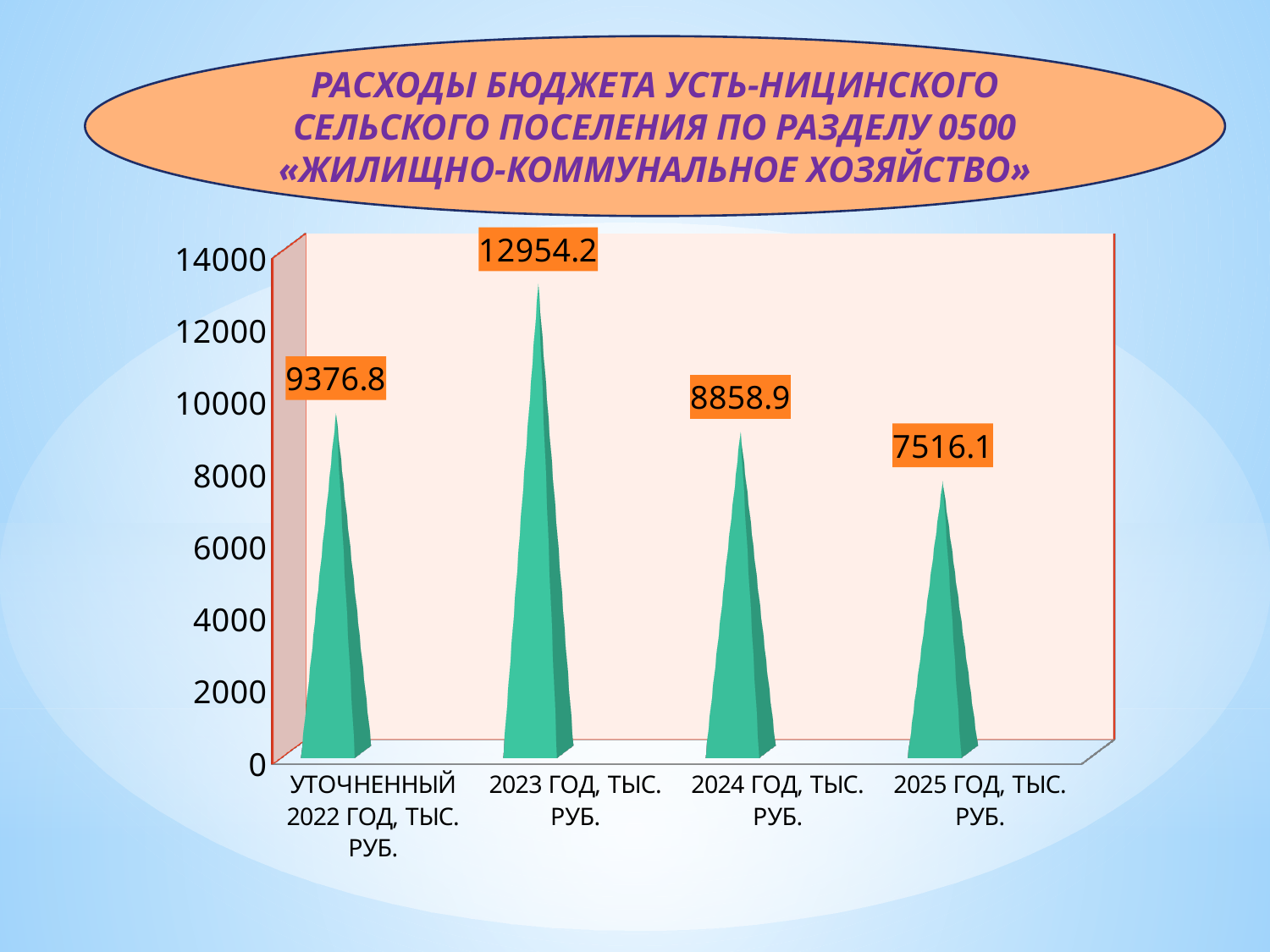
What is the difference between the values for 2024 год and 2025 год? 1342.8 How many categories are shown on the x axis? 4 From 2023 год to 2025 год, do the values rise or fall? fall What is the value for 2023 год, тыс. руб.? 12954.2 What is the difference between the values for 2023 год and Уточненный 2022 год? 3577.4 What is the value for 2025 год, тыс. руб.? 7516.1 What is the value for Уточненный 2022 год, тыс. руб.? 9376.8 What kind of chart is shown on the slide? bar chart Is the value for 2024 год, тыс. руб. greater or less than 10000? less Which category has the lowest value? 2025 год, тыс. руб. Which is larger, the value for Уточненный 2022 год or the value for 2024 год? Уточненный 2022 год Which category has the highest value? 2023 год, тыс. руб.